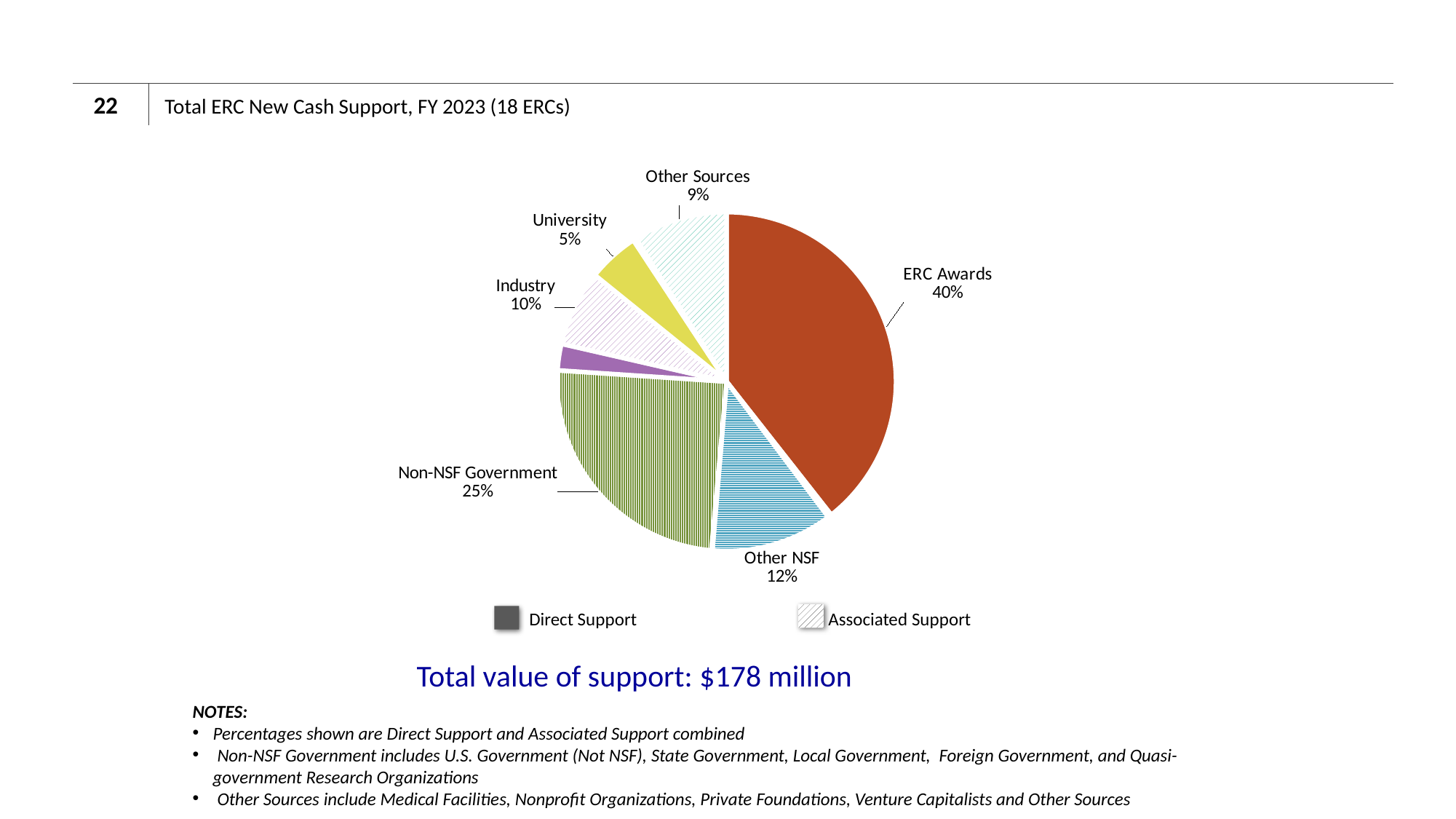
What kind of chart is shown on the slide? pie chart What are the two legend entries shown below the pie chart? Direct Support and Associated Support What percentage of total ERC new cash support comes from ERC Awards? 40% What percentage of support comes from Other Sources? 9% Which is larger, the Other NSF share or the Industry share? Other NSF What percentage of support comes from Non-NSF Government? 25% How many labelled slices does the pie chart have? 6 Which source accounts for the smallest share of support? University Which source accounts for the largest share of support? ERC Awards What percentage of support comes from Industry? 10% What is the total value of support stated below the chart? $178 million How many percentage points larger is the ERC Awards share than the Non-NSF Government share? 15